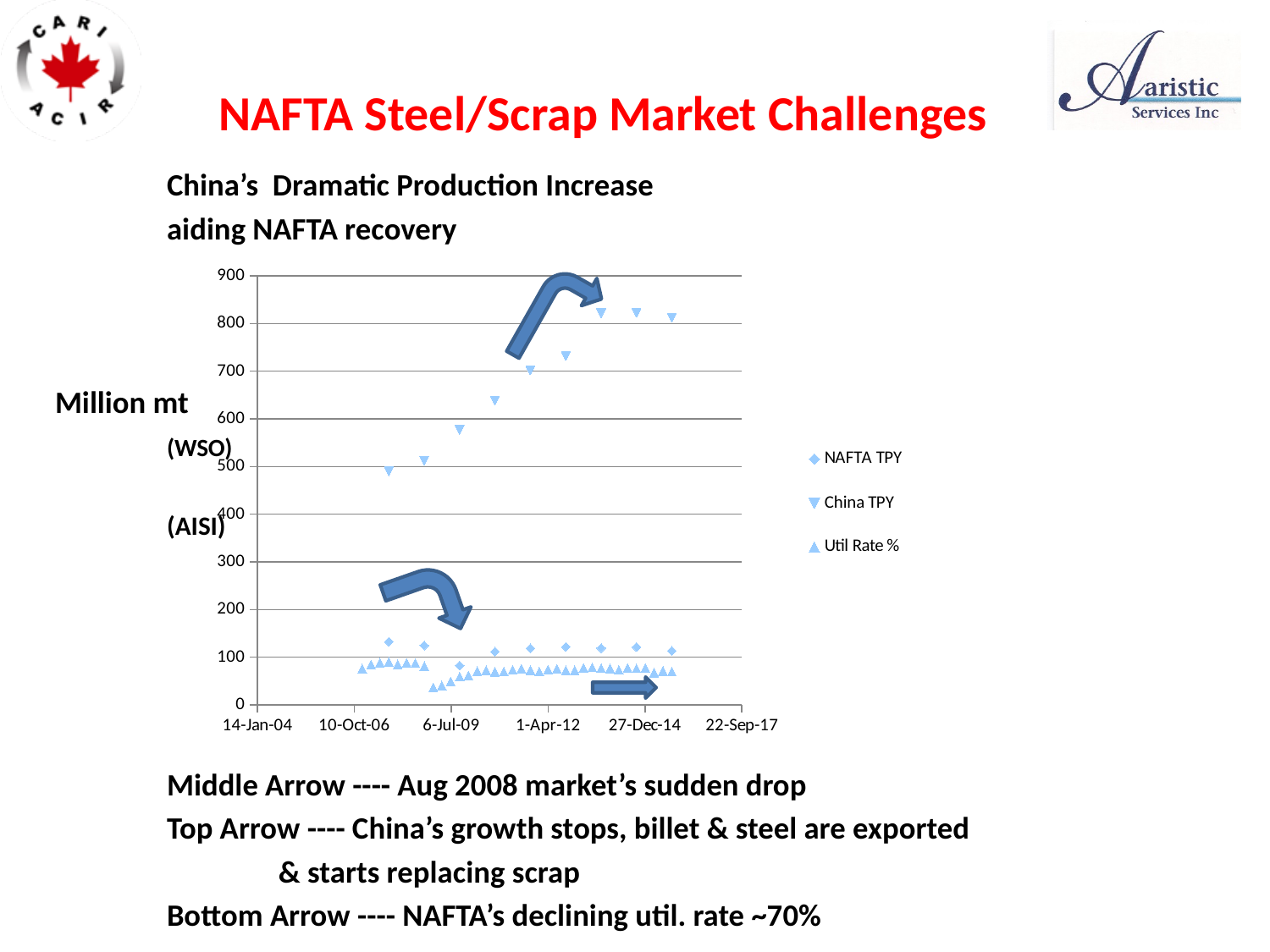
Which series has the highest plotted values on the chart? China TPY Is the highest China TPY value greater or less than 700? greater Are the China TPY values greater or less than 400 throughout the chart? greater What is the first date label on the x axis? 14-Jan-04 What is the highest value shown on the y axis? 900 Which series has the lowest plotted values on the chart? Util Rate % Are the NAFTA TPY values greater or less than 200 throughout the chart? less Do the China TPY values rise or fall along the x axis from 2007 to 2012? rise Which series is plotted higher on the chart, China TPY or NAFTA TPY? China TPY What kind of chart is shown on the slide? scatter chart How many series does the legend list? 3 How many date labels are shown on the x axis? 6